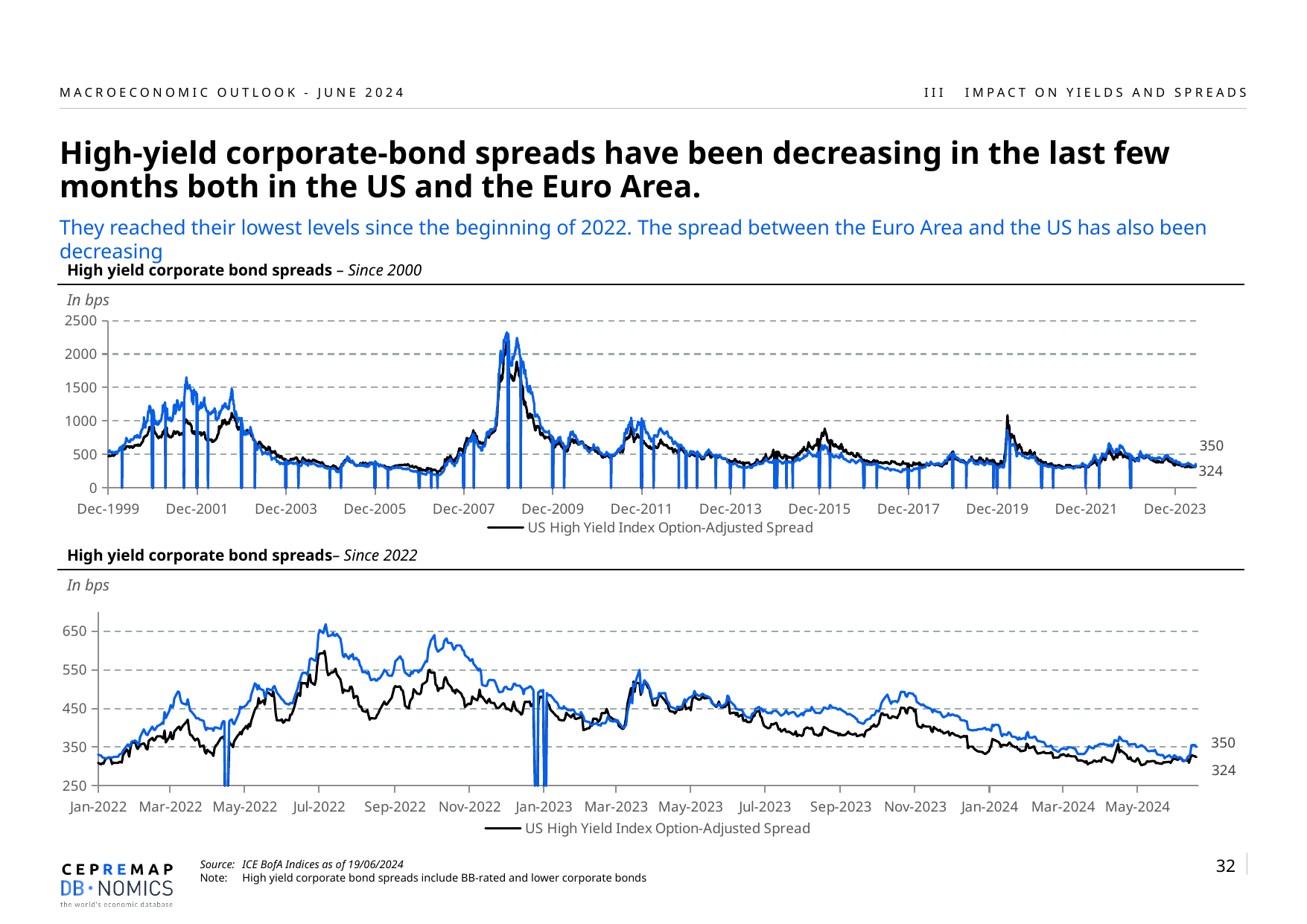
In the bottom chart (Since 2022), is the peak of the blue line around Jul-2022 greater or less than 550? greater In the bottom chart (Since 2022), what is the difference between the two end-of-series labels, 350 and 324? 26 In the bottom chart (Since 2022), what is the latest value labelled for the blue line? 350 How many series does the legend of the top chart (Since 2000) list? 1 In the top chart (Since 2000), is the peak value of the US High Yield Index Option-Adjusted Spread around Dec-2008 greater or less than 2000? greater In the bottom chart (Since 2022), which line ends higher, the blue line or the black US High Yield Index Option-Adjusted Spread line? The blue line What is the highest value labelled on the y axis of the top chart (Since 2000)? 2500 In the top chart (Since 2000), what is the latest value shown for the US High Yield Index Option-Adjusted Spread (black line)? 324 What unit is shown for the y axis of both charts? In bps In the bottom chart (Since 2022), does the US High Yield Index Option-Adjusted Spread rise or fall between Nov-2023 and May-2024? Fall How many labelled tick marks are on the x axis of the bottom chart (Since 2022)? 15 What kind of chart is the top chart, 'High yield corporate bond spreads – Since 2000'? Line chart